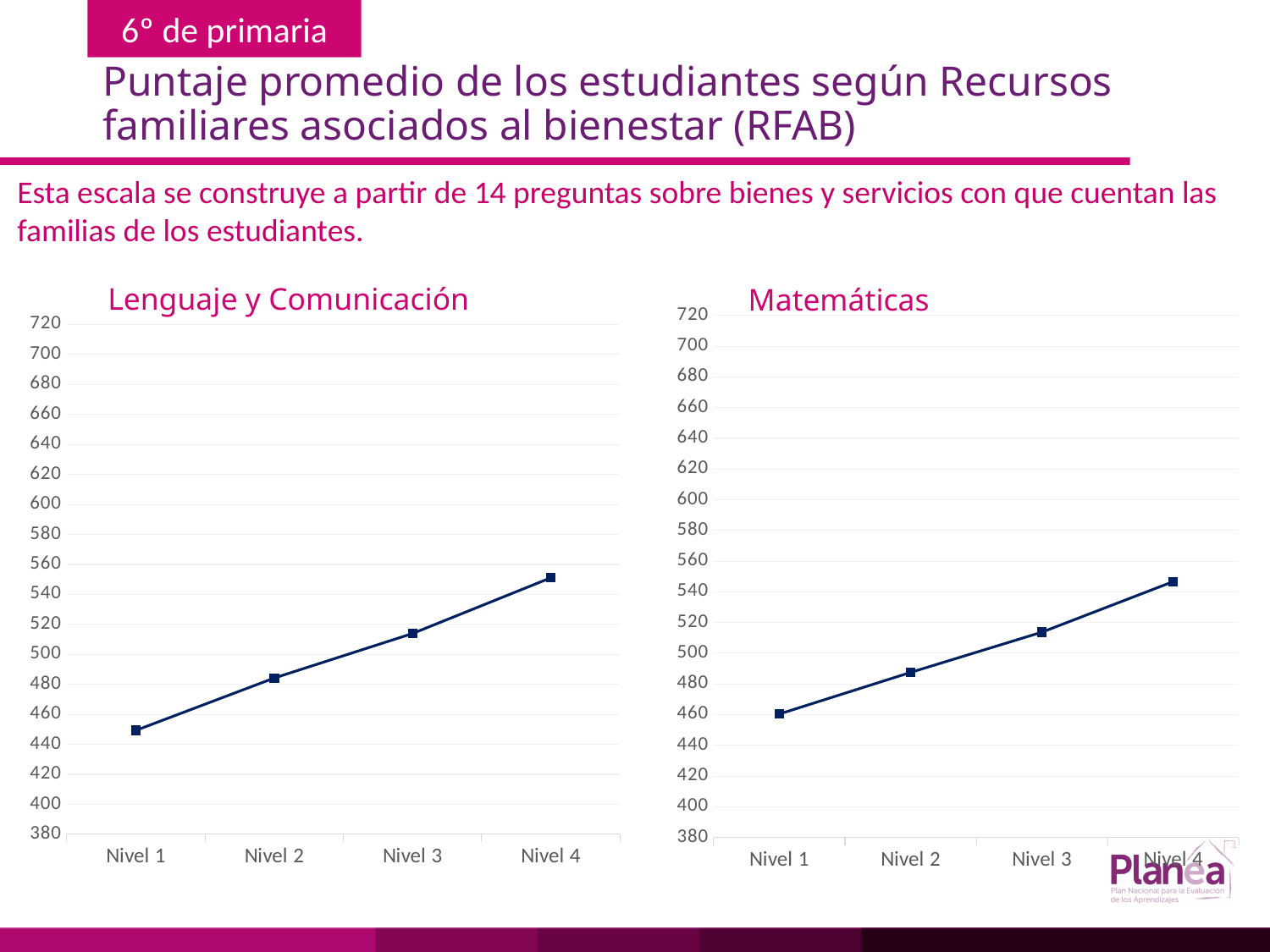
In the Lenguaje y Comunicación chart, is the value for Nivel 1 greater or less than 460? less In the Lenguaje y Comunicación chart, which level has the highest score? Nivel 4 In the Matemáticas chart, is the value for Nivel 4 greater or less than 540? greater In the Lenguaje y Comunicación chart, is the value for Nivel 4 greater or less than 540? greater What is the title of the chart on the right side of the slide? Matemáticas In the Matemáticas chart, do the values rise or fall from Nivel 1 to Nivel 4? rise In the Matemáticas chart, which level has the lowest score? Nivel 1 What kind of chart is the Lenguaje y Comunicación chart? line chart In the Lenguaje y Comunicación chart, do the values rise or fall from Nivel 1 to Nivel 4? rise In the Lenguaje y Comunicación chart, which is larger, the value for Nivel 2 or the value for Nivel 3? Nivel 3 How many categories are shown on the x axis of the Matemáticas chart? 4